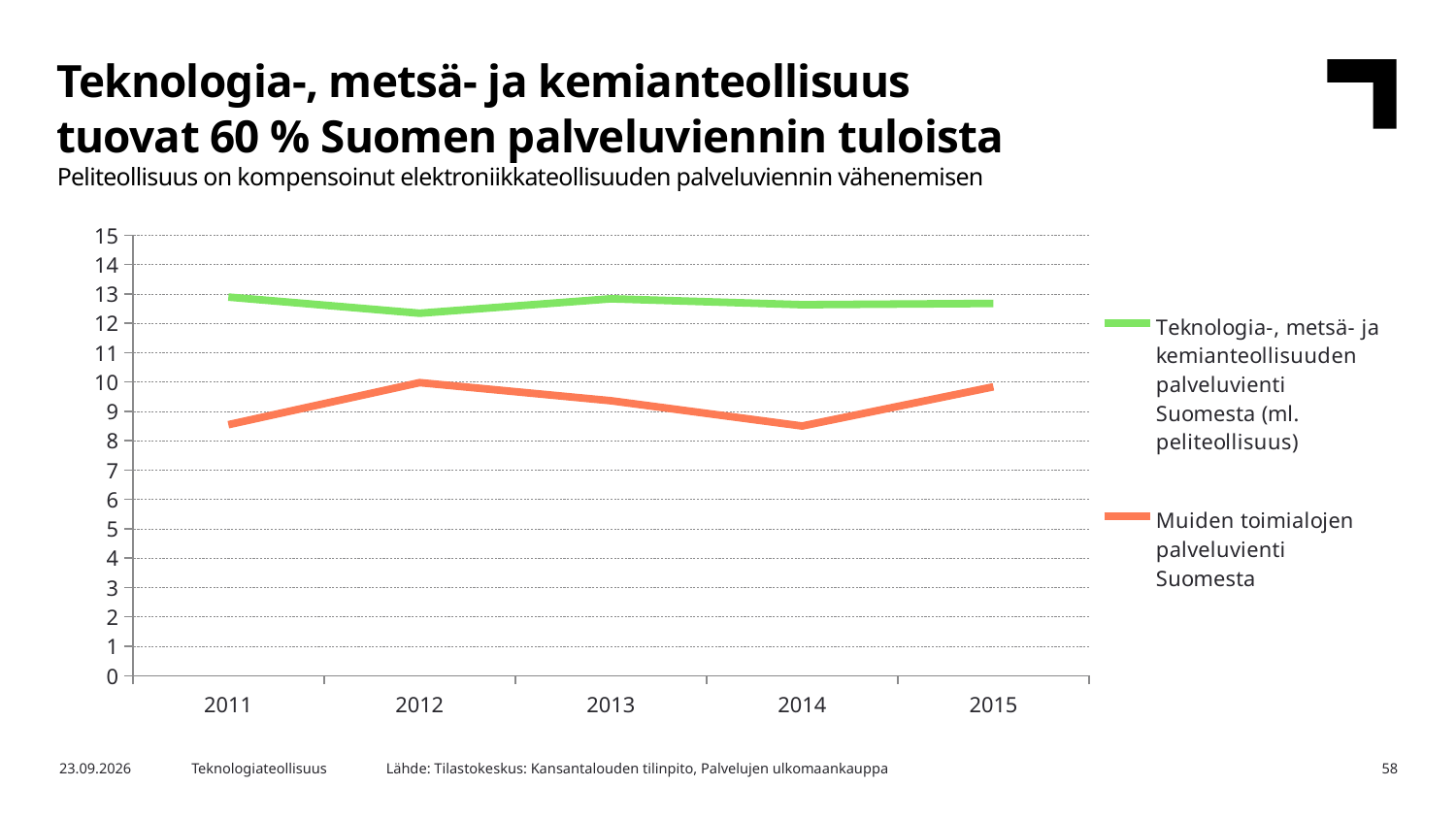
Which colour is used for the Muiden toimialojen palveluvienti Suomesta line? orange Is the value for Muiden toimialojen palveluvienti Suomesta in 2014 greater or less than 9? less How many series does the legend list? 2 Is the value for Muiden toimialojen palveluvienti Suomesta in 2015 greater or less than 9? greater Is the value for Teknologia-, metsä- ja kemianteollisuuden palveluvienti Suomesta in 2011 greater or less than 12? greater In which year is the value for Teknologia-, metsä- ja kemianteollisuuden palveluvienti Suomesta lowest? 2012 Does the value for Muiden toimialojen palveluvienti Suomesta rise or fall from 2012 to 2014? fall Does the value for Muiden toimialojen palveluvienti Suomesta rise or fall from 2011 to 2012? rise Which series has the higher value in 2013, Teknologia-, metsä- ja kemianteollisuuden palveluvienti Suomesta or Muiden toimialojen palveluvienti Suomesta? Teknologia-, metsä- ja kemianteollisuuden palveluvienti Suomesta What kind of chart is shown on the slide? line chart How many years are plotted along the x axis? 5